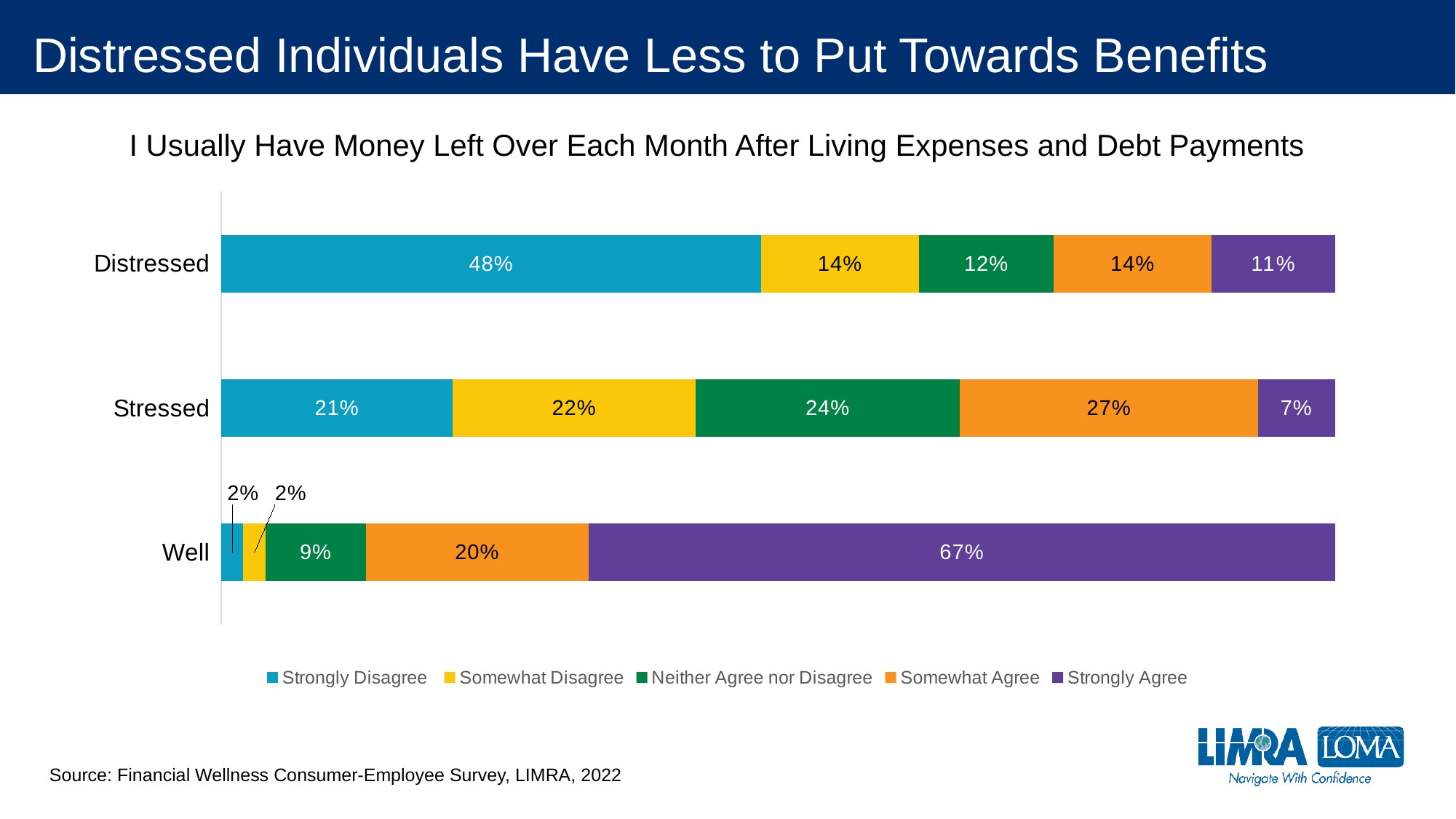
What kind of chart is shown? Stacked bar chart What is the difference between the Strongly Disagree percentages for Distressed and Stressed? 27% What percentage of Stressed respondents Somewhat Agree? 27% Which group has the lowest Strongly Disagree percentage? Well What is the title of the chart? I Usually Have Money Left Over Each Month After Living Expenses and Debt Payments What percentage of Well respondents Strongly Agree? 67% What percentage of Well respondents Neither Agree nor Disagree? 9% Which is larger: the Somewhat Agree percentage for Stressed or for Well? Stressed Which group has the highest Strongly Agree percentage? Well How many series does the legend list? 5 How many groups (categories) are shown on the chart? 3 What percentage of Distressed respondents Strongly Disagree? 48%